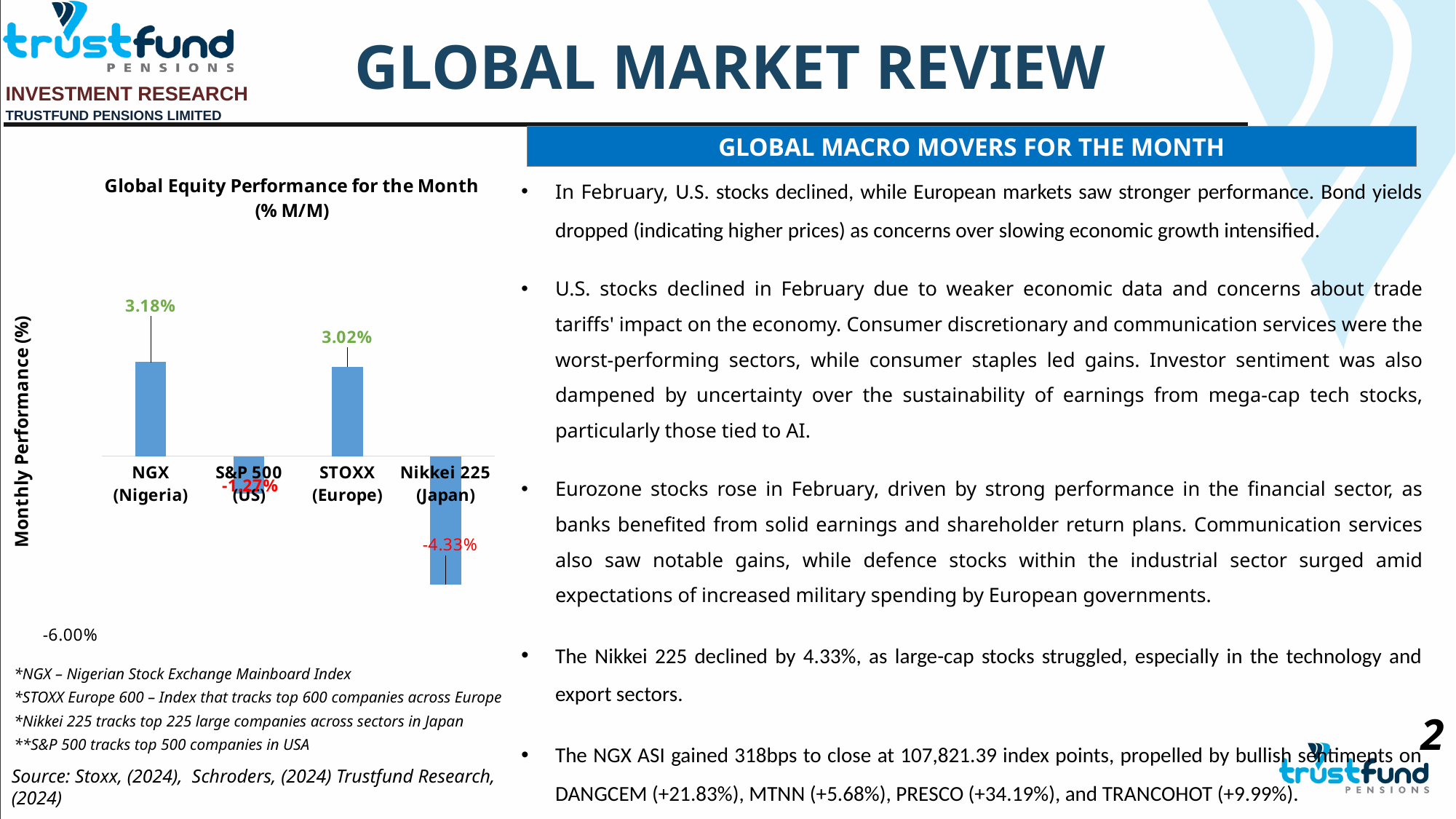
What kind of chart is the Global Equity Performance for the Month chart? Bar chart What is the label on the vertical axis of the Global Equity Performance for the Month chart? Monthly Performance (%) What is the value for Nikkei 225 (Japan) in the Global Equity Performance for the Month chart? -4.33% Which index has the highest monthly performance in the chart? NGX (Nigeria) What is the value for NGX (Nigeria) in the Global Equity Performance for the Month chart? 3.18% What is the difference between the S&P 500 (US) and Nikkei 225 (Japan) values in the chart? 3.06% What is the value for STOXX (Europe) in the Global Equity Performance for the Month chart? 3.02% How many indices are plotted in the Global Equity Performance for the Month chart? 4 What is the value for S&P 500 (US) in the Global Equity Performance for the Month chart? -1.27% What is the difference between the NGX (Nigeria) and STOXX (Europe) values in the chart? 0.16% Which is larger in the chart, the value for S&P 500 (US) or the value for Nikkei 225 (Japan)? S&P 500 (US) Which index has the lowest monthly performance in the chart? Nikkei 225 (Japan)